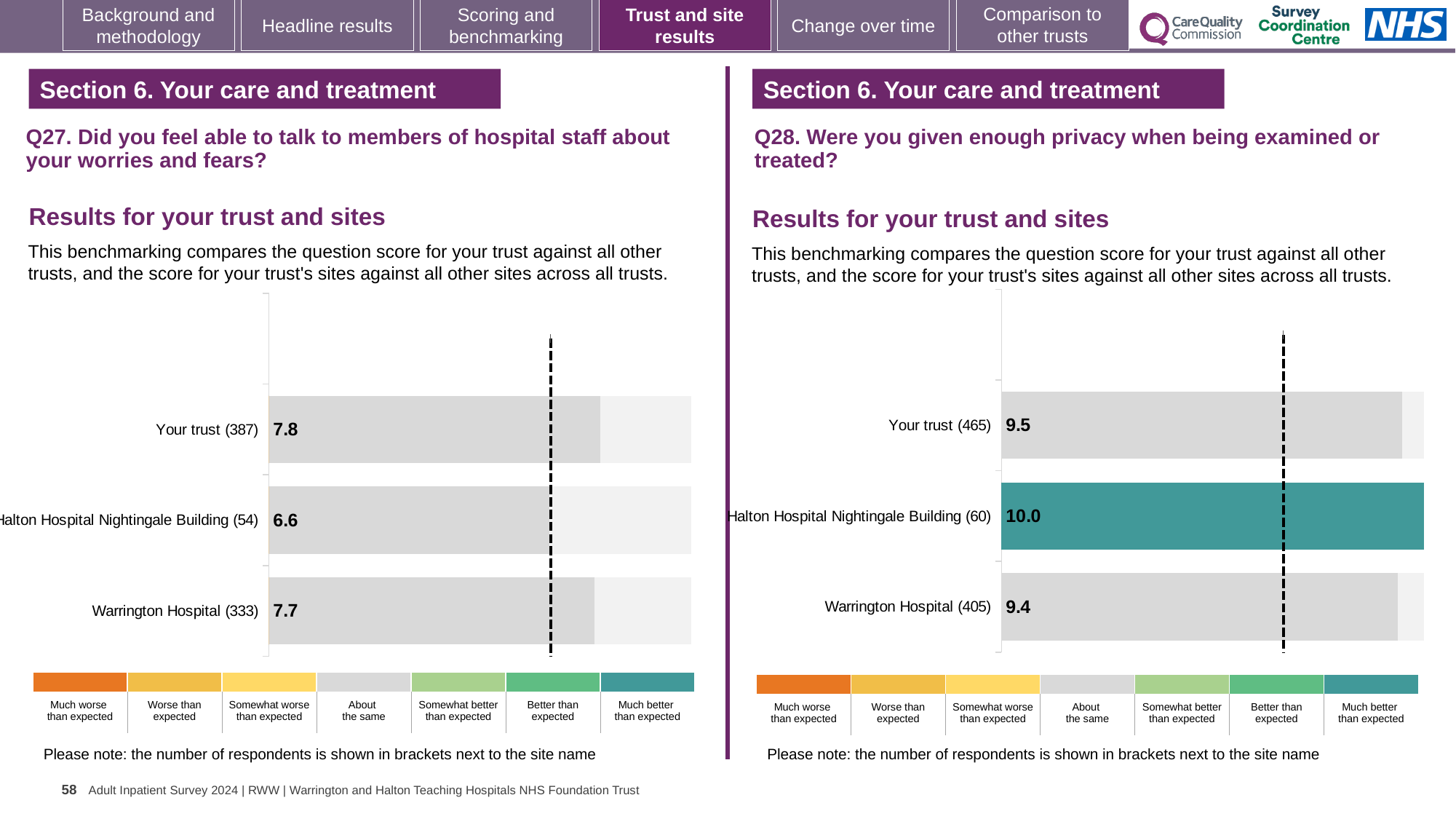
In the Q28 chart on the right, which site or trust has the highest score? Halton Hospital Nightingale Building (60) In the Q28 chart on the right, which benchmark category does the colour of the Halton Hospital Nightingale Building (60) bar correspond to? Much better than expected What type of chart is used for the Q28 results on the right? Bar chart In the Q27 chart on the left, which site or trust has the lowest score? Halton Hospital Nightingale Building (54) In the Q28 chart on the right, what is the score for Warrington Hospital (405)? 9.4 In the Q28 chart on the right, which has the larger score: Your trust (465) or Warrington Hospital (405)? Your trust (465) In the Q28 chart on the right, what is the score for Halton Hospital Nightingale Building (60)? 10.0 How many bars are plotted in the Q27 chart on the left? 3 In the Q27 chart on the left, what is the difference between the scores for Your trust (387) and Halton Hospital Nightingale Building (54)? 1.2 In the Q27 chart on the left, what is the score for Your trust (387)? 7.8 In the Q27 chart on the left, what is the score for Warrington Hospital (333)? 7.7 In the Q28 chart on the right, what is the difference between the scores for Halton Hospital Nightingale Building (60) and Your trust (465)? 0.5